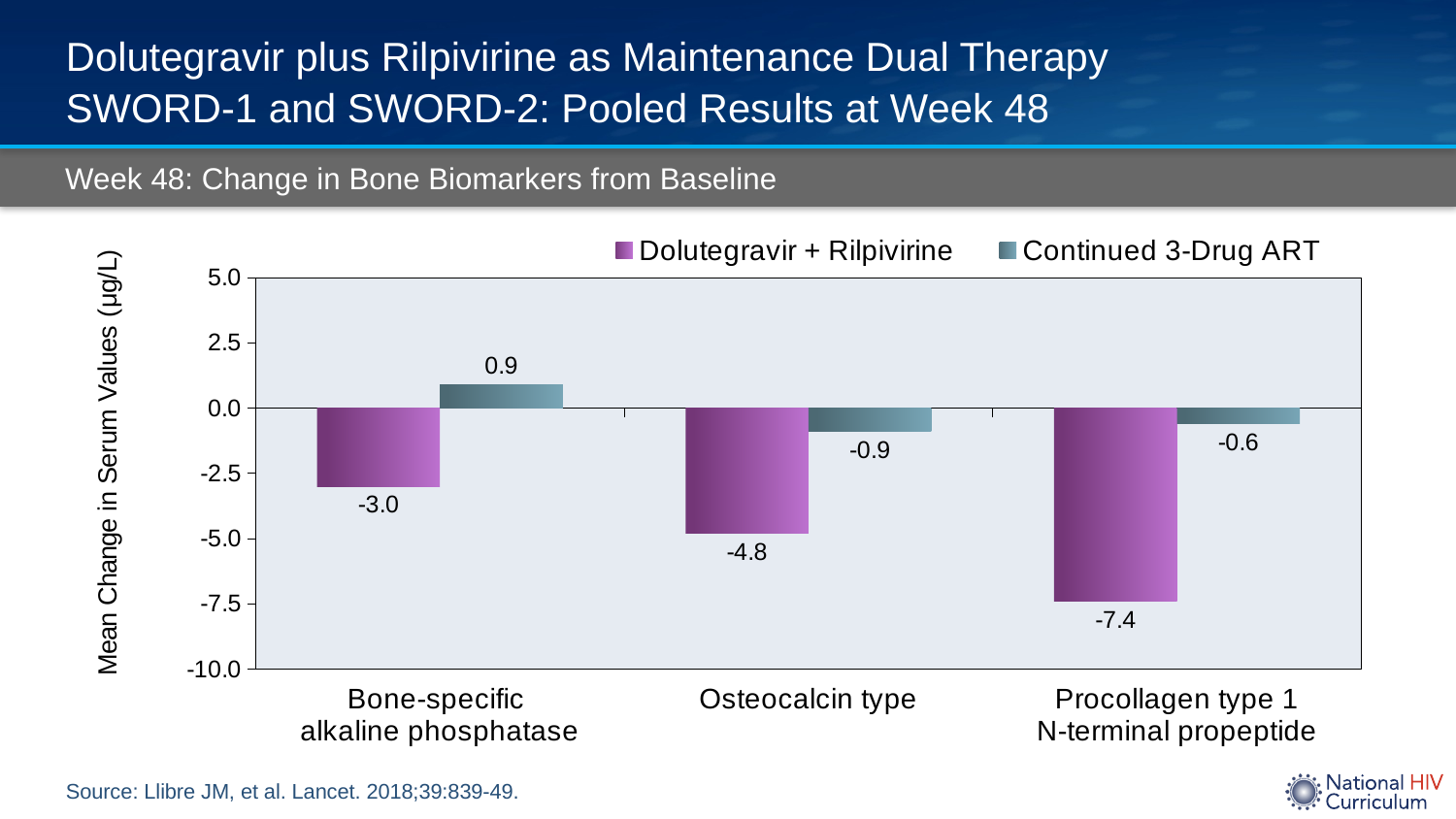
What is the mean change in serum value for Bone-specific alkaline phosphatase in the Continued 3-Drug ART group? 0.9 What is the difference between the Dolutegravir + Rilpivirine and Continued 3-Drug ART values for Osteocalcin type? 3.9 How many series does the legend list? 2 What kind of chart is shown on the slide? Bar chart What is the mean change in serum value for Bone-specific alkaline phosphatase in the Dolutegravir + Rilpivirine group? -3.0 What is the mean change in serum value for Procollagen type 1 N-terminal propeptide in the Dolutegravir + Rilpivirine group? -7.4 Which biomarker shows the lowest (most negative) mean change in the Dolutegravir + Rilpivirine group? Procollagen type 1 N-terminal propeptide What is the y-axis label of the chart? Mean Change in Serum Values (µg/L) How many biomarker categories are shown on the x axis? 3 What is the mean change in serum value for Osteocalcin type in the Continued 3-Drug ART group? -0.9 For Procollagen type 1 N-terminal propeptide, which group has the larger (less negative) mean change? Continued 3-Drug ART Which biomarker shows the highest mean change in the Continued 3-Drug ART group? Bone-specific alkaline phosphatase